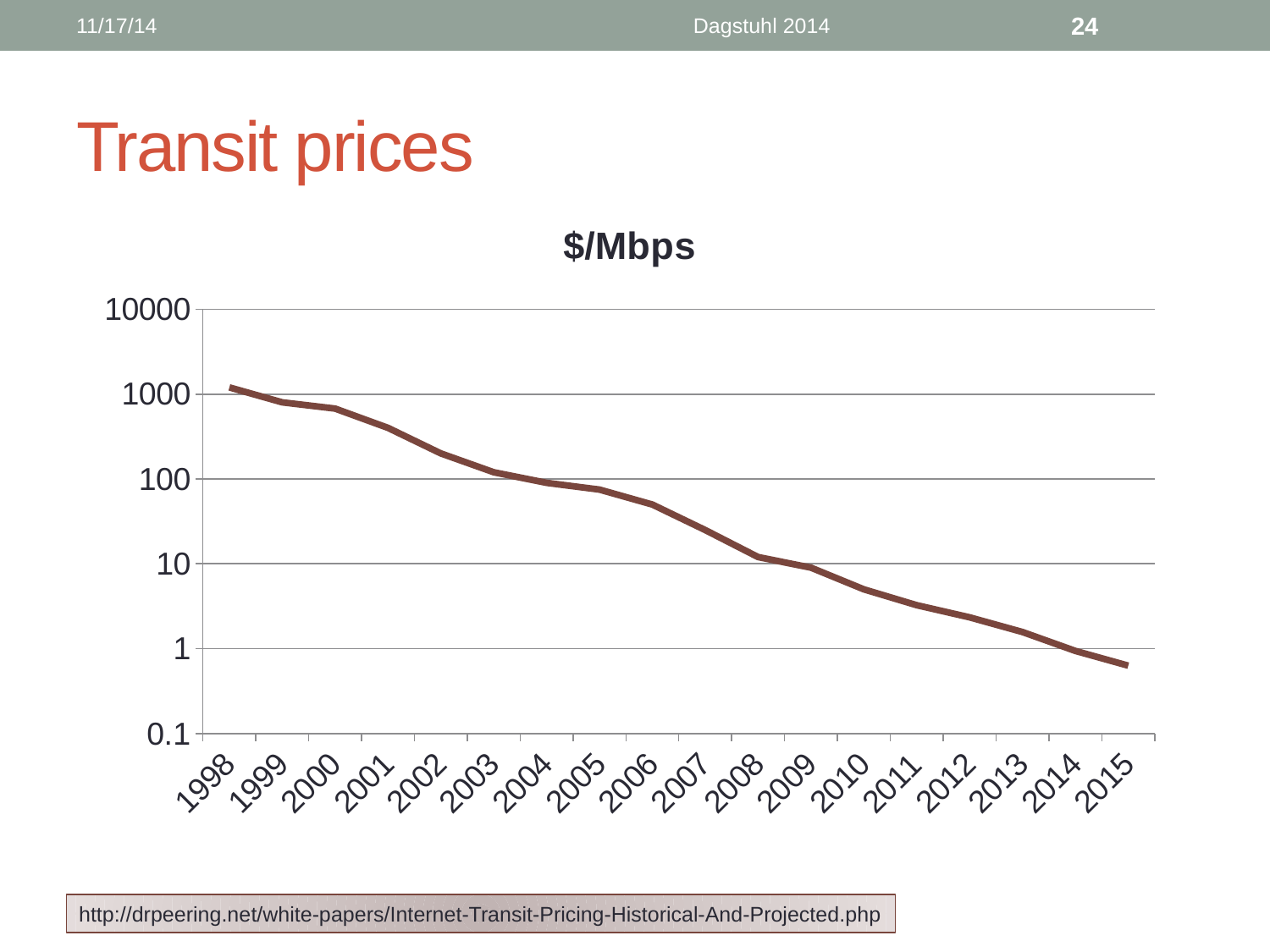
Is the value for 2002 greater or less than 100? greater Do the values rise or fall from 1998 to 2015? fall Which year has the lowest value? 2015 Is the value for 1998 greater or less than 1000? greater Is the value for 2000 greater or less than 1000? less Which year has the larger value, 2002 or 2010? 2002 What is the title of the chart? $/Mbps Which year has the highest value? 1998 What kind of chart is shown on the slide? line chart How many years are plotted along the x axis? 18